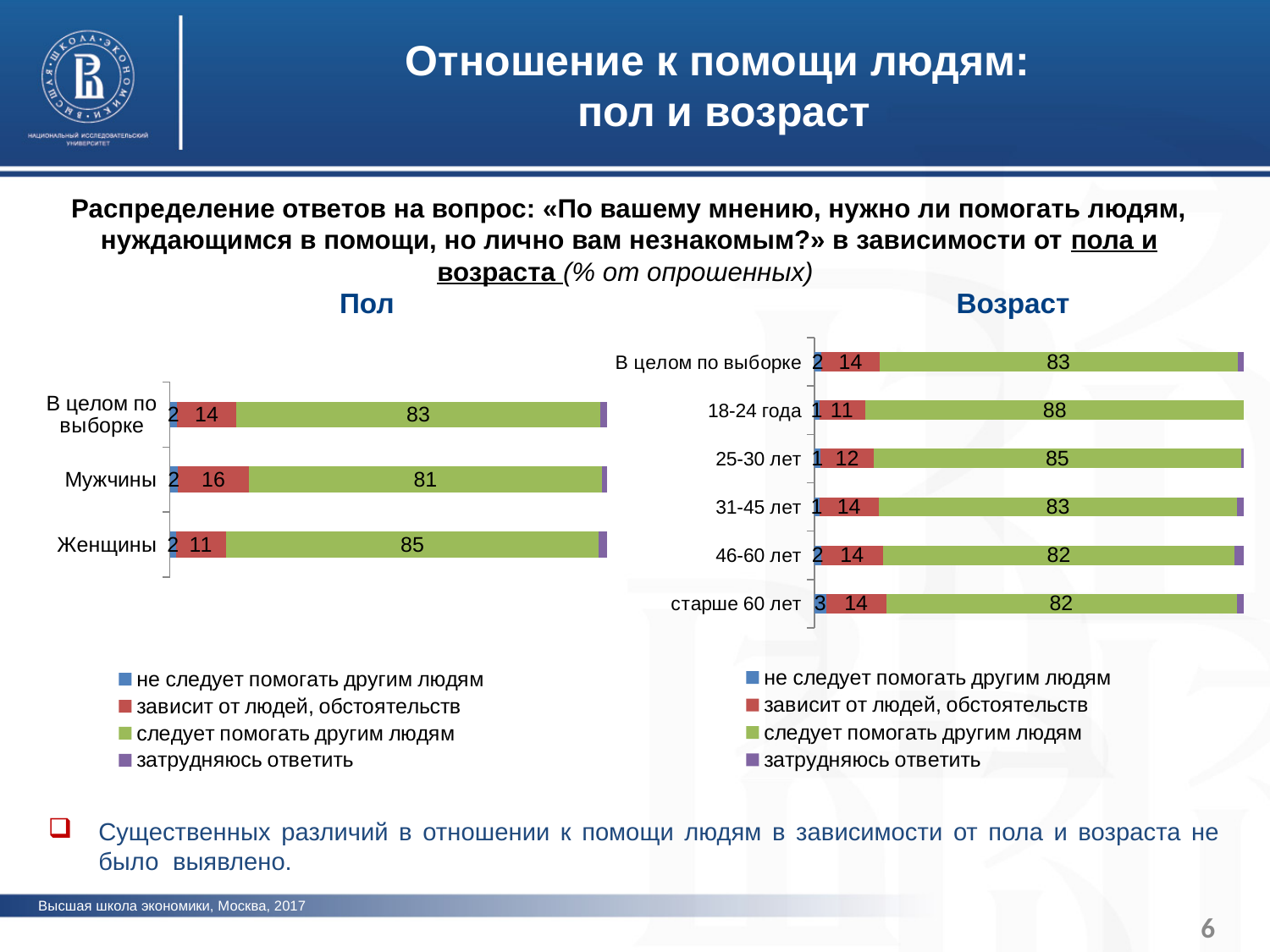
In the chart titled «Возраст», which age group has the highest value for «следует помогать другим людям»? 18-24 года In the chart titled «Пол», what is the value for «зависит от людей, обстоятельств» for «Женщины»? 11 What kind of chart is the chart titled «Возраст»? Stacked bar chart In the chart titled «Возраст», how many categories are shown? 6 In the chart titled «Пол», what is the difference between the «зависит от людей, обстоятельств» values for «Мужчины» and «Женщины»? 5 In the chart titled «Пол», how many series does the legend list? 4 In the chart titled «Возраст», what is the value for «не следует помогать другим людям» for «старше 60 лет»? 3 In the chart titled «Пол», how many categories are shown? 3 In the chart titled «Возраст», which has the larger value for «следует помогать другим людям»: «25-30 лет» or «31-45 лет»? 25-30 лет In the chart titled «Пол», what is the value for «следует помогать другим людям» for «Мужчины»? 81 In the chart titled «Возраст», what is the value for «следует помогать другим людям» for «18-24 года»? 88 In the chart titled «Пол», which category has the highest value for «следует помогать другим людям»? Женщины